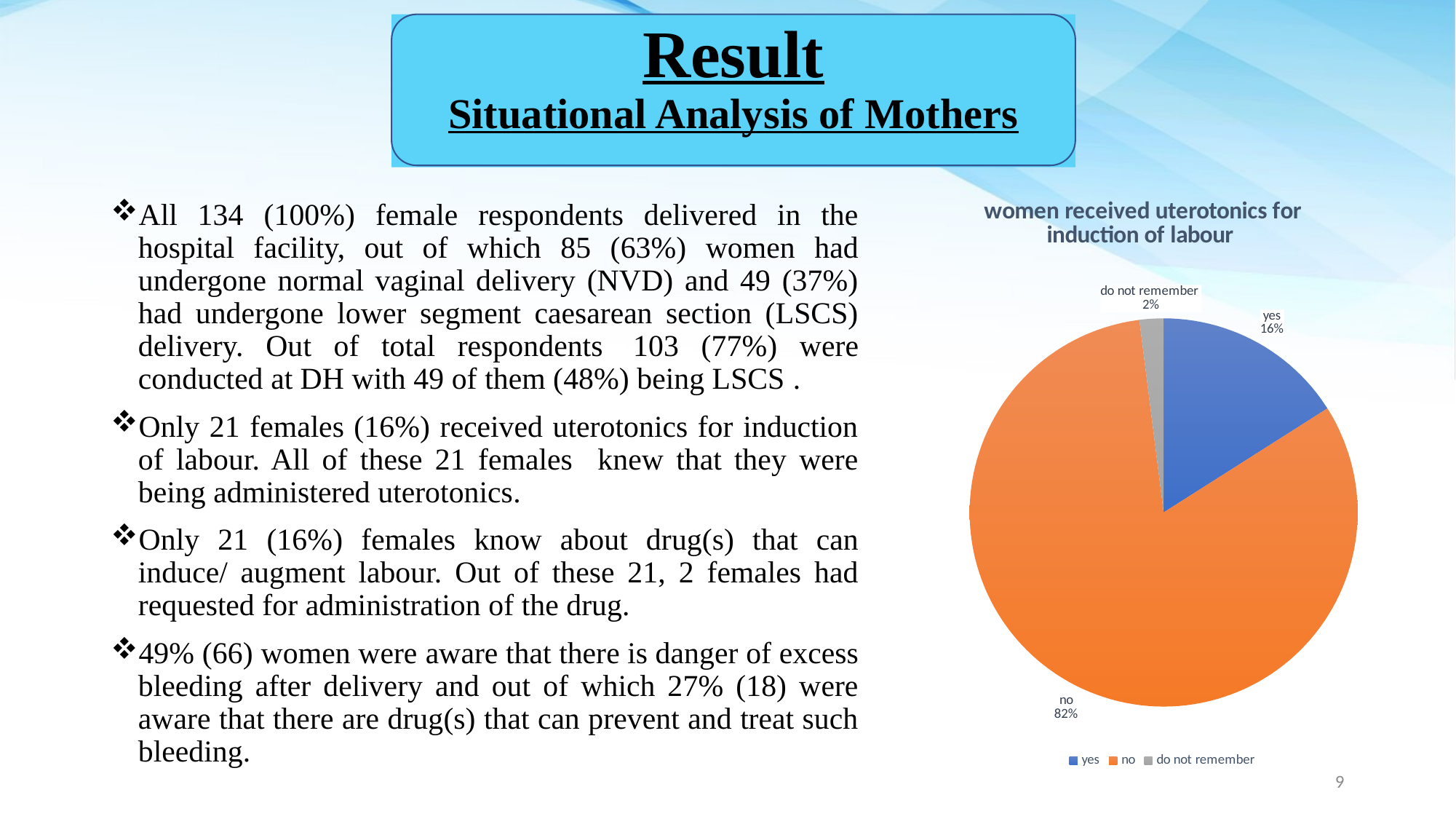
What is the difference in percentage points between the "no" and "yes" slices? 66 What colour is the "no" slice in the pie chart? orange Which category has the largest slice of the pie chart? no What percentage of women answered "no" in the pie chart? 82% How many slices does the pie chart have? 3 What percentage of women answered "do not remember" in the pie chart? 2% What is the title of the chart? women received uterotonics for induction of labour Which slice is larger, "yes" or "do not remember"? yes What percentage of women answered "yes" in the pie chart? 16% Which category has the smallest slice of the pie chart? do not remember What type of chart is shown on the slide? pie chart How many entries does the legend of the pie chart list? 3